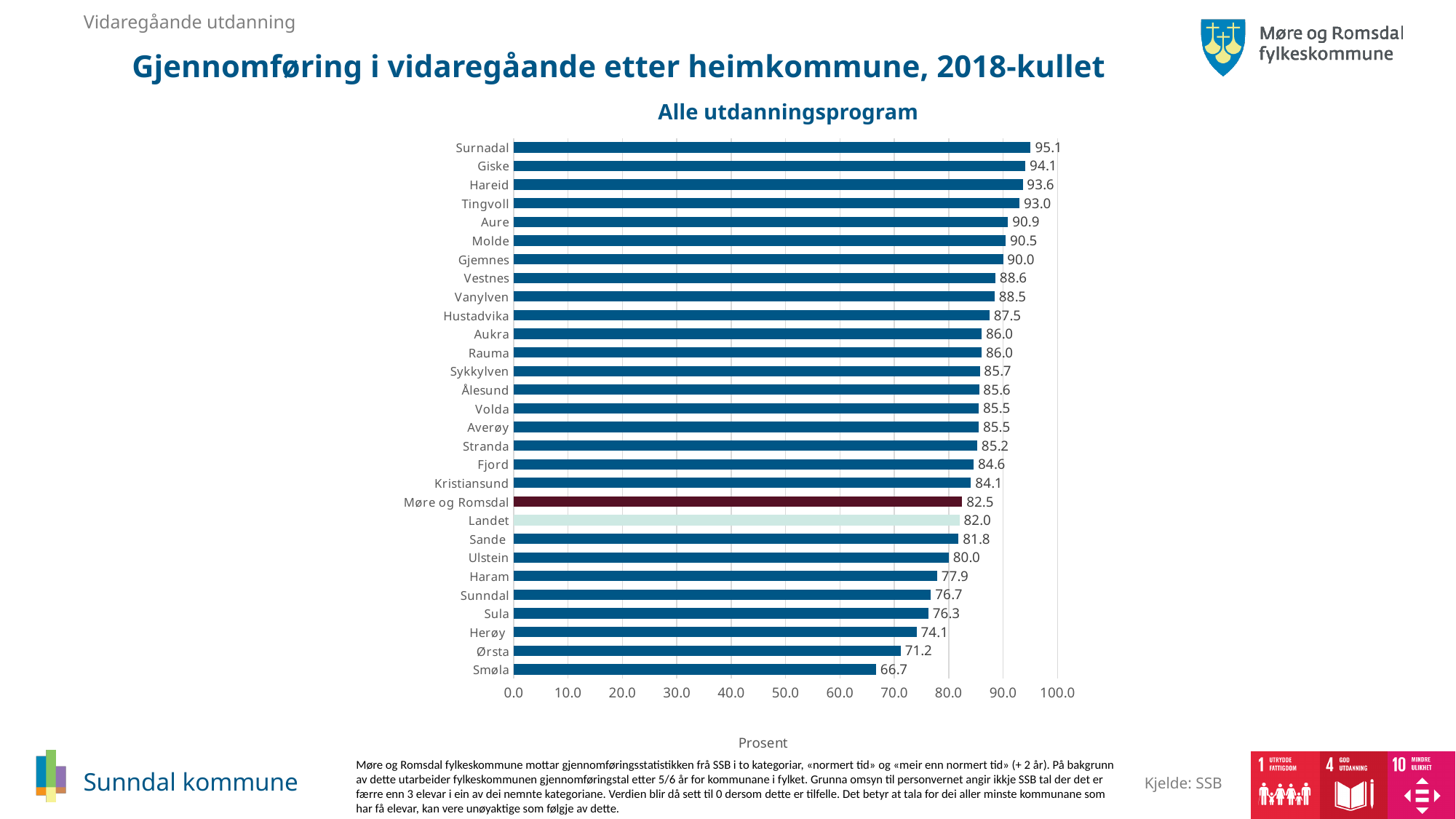
What is the difference between the values for Møre og Romsdal and Sunndal? 5.8 What is the value for Sunndal? 76.7 What kind of chart is shown on the slide? bar chart What is the difference between the values for Surnadal and Smøla? 28.4 What is the value for Landet? 82.0 Is the value for Ørsta greater or less than 80.0? less Which category has the lowest value? Smøla Which category has the highest value? Surnadal How many categories are shown in the chart? 29 What is the title of the chart? Alle utdanningsprogram What is the value for Møre og Romsdal? 82.5 Which is larger, the value for Molde or the value for Kristiansund? Molde